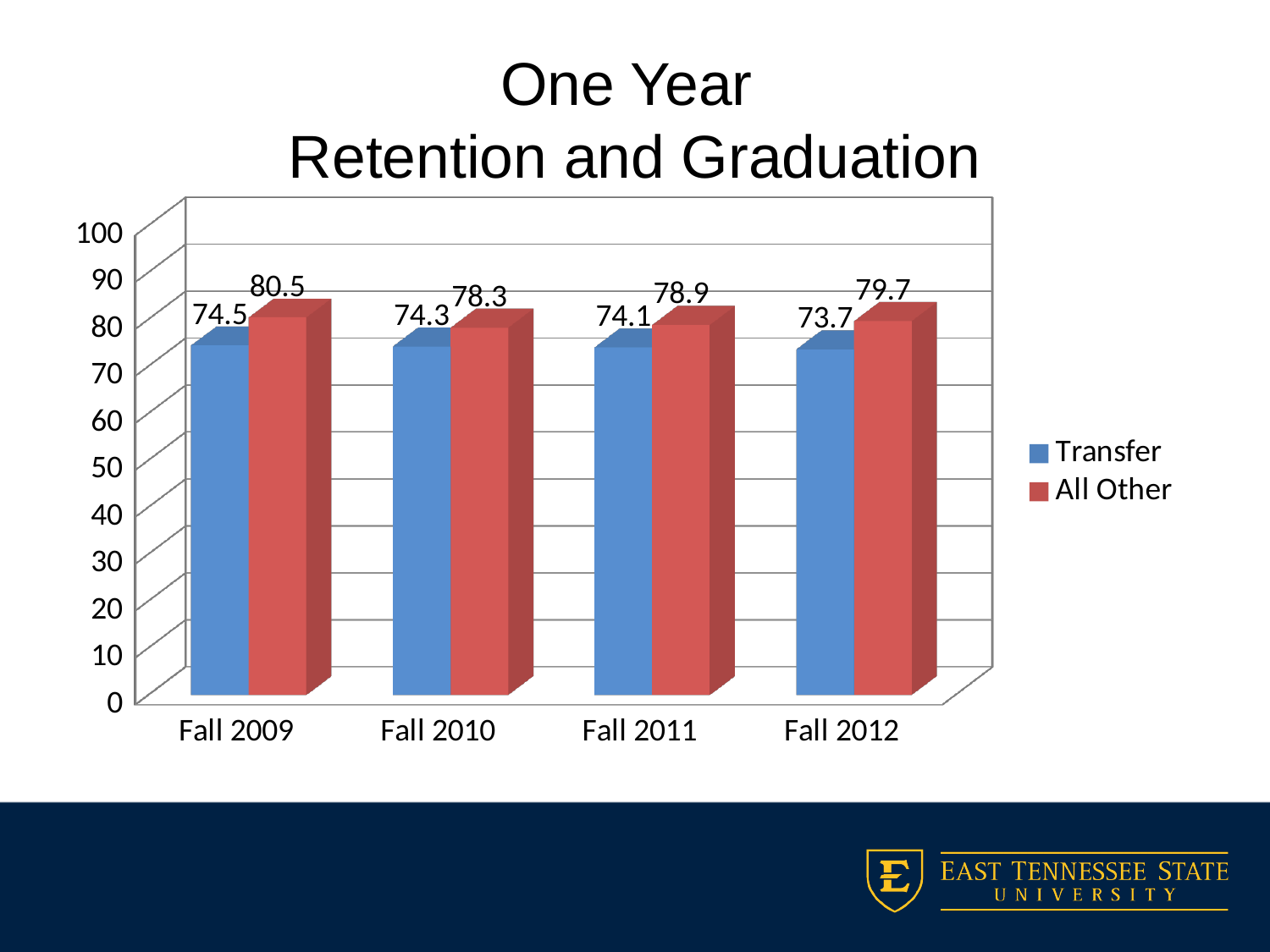
What is the Transfer value for Fall 2009? 74.5 What is the All Other value for Fall 2011? 78.9 What is the Transfer value for Fall 2012? 73.7 How many years are shown on the x axis? 4 Which is larger for Fall 2011, the Transfer value or the All Other value? All Other Which year has the lowest Transfer value? Fall 2012 What is the difference between the All Other and Transfer values for Fall 2012? 6 How many series does the legend list? 2 What kind of chart is shown on the slide? Bar chart What is the difference between the All Other and Transfer values for Fall 2010? 4 Which year has the highest All Other value? Fall 2009 Do the Transfer values rise or fall from Fall 2009 to Fall 2012? Fall